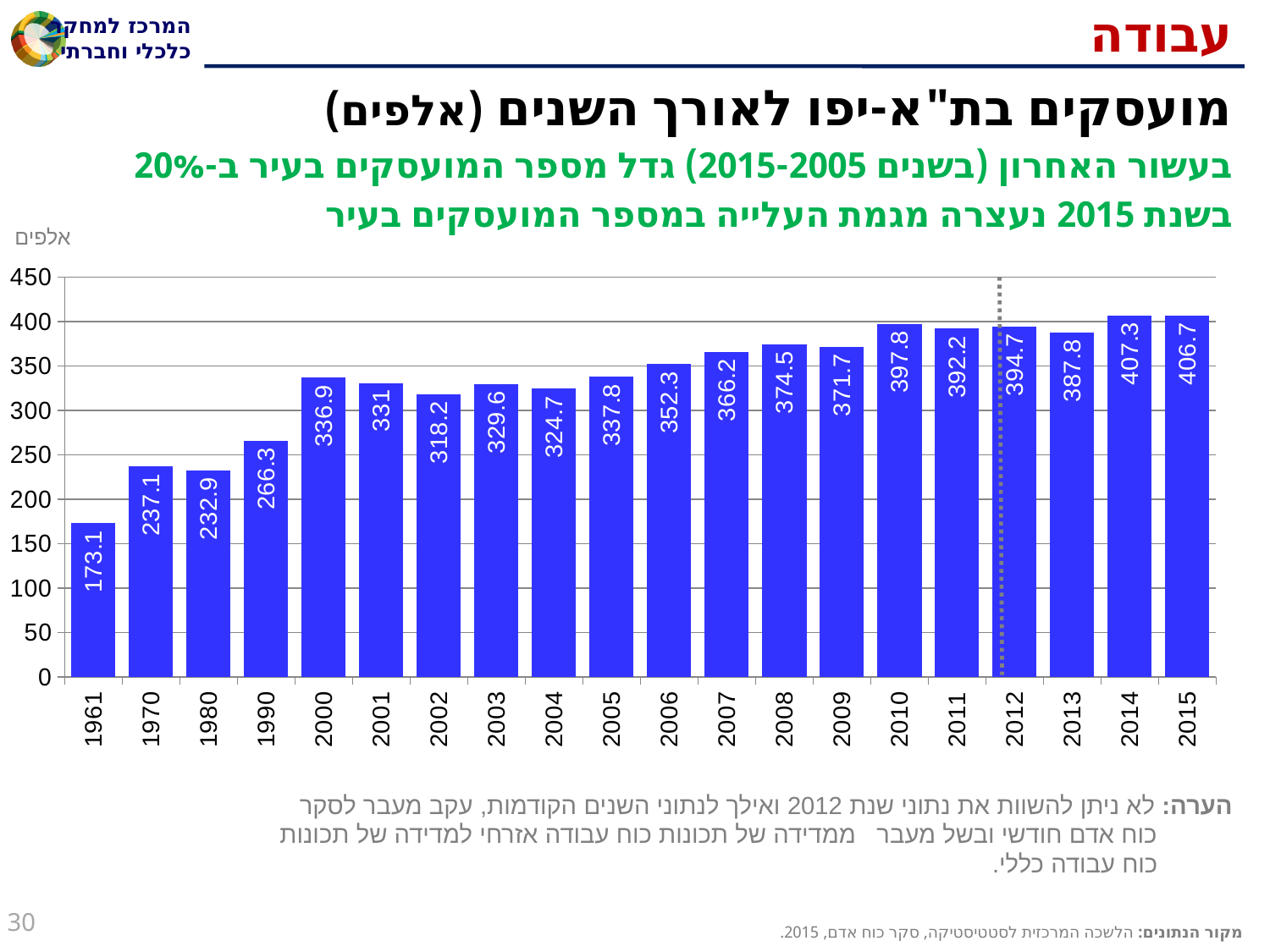
Which year has the highest value? 2014 What is the value for 2010? 397.8 Which is larger, the value for 1970 or the value for 1980? 1970 Which year has the lowest value? 1961 What is the value for 1961? 173.1 What is the value for 2005? 337.8 What is the difference between the values for 2014 and 2013? 19.5 What is the difference between the values for 2015 and 2005? 68.9 Do the values generally rise or fall from 2005 to 2015? rise What is the value for 2015? 406.7 How many years are shown on the x axis? 20 What kind of chart is shown on the slide? bar chart